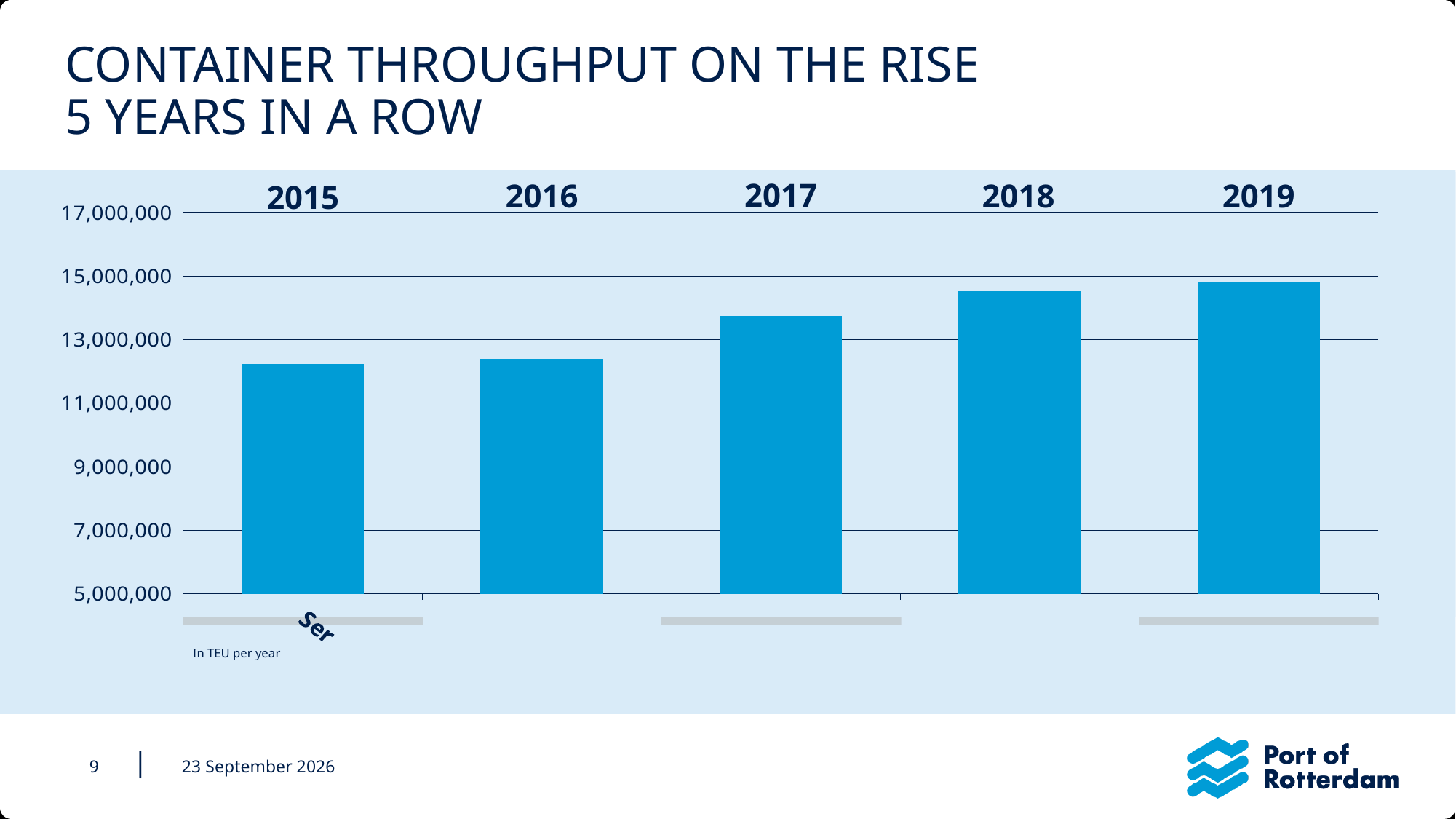
Which year has the highest container throughput? 2019 Which is larger, the value for 2018 or the value for 2016? 2018 Is the value for 2019 greater or less than 13,000,000? greater Do the values rise or fall from 2015 to 2019? rise In what unit are the chart values expressed, according to the note below the chart? TEU per year Is the value for 2018 greater or less than 15,000,000? less Which is larger, the value for 2015 or the value for 2017? 2017 What kind of chart is shown on the slide? bar chart Is the value for 2015 greater or less than 13,000,000? less How many years are plotted in the chart? 5